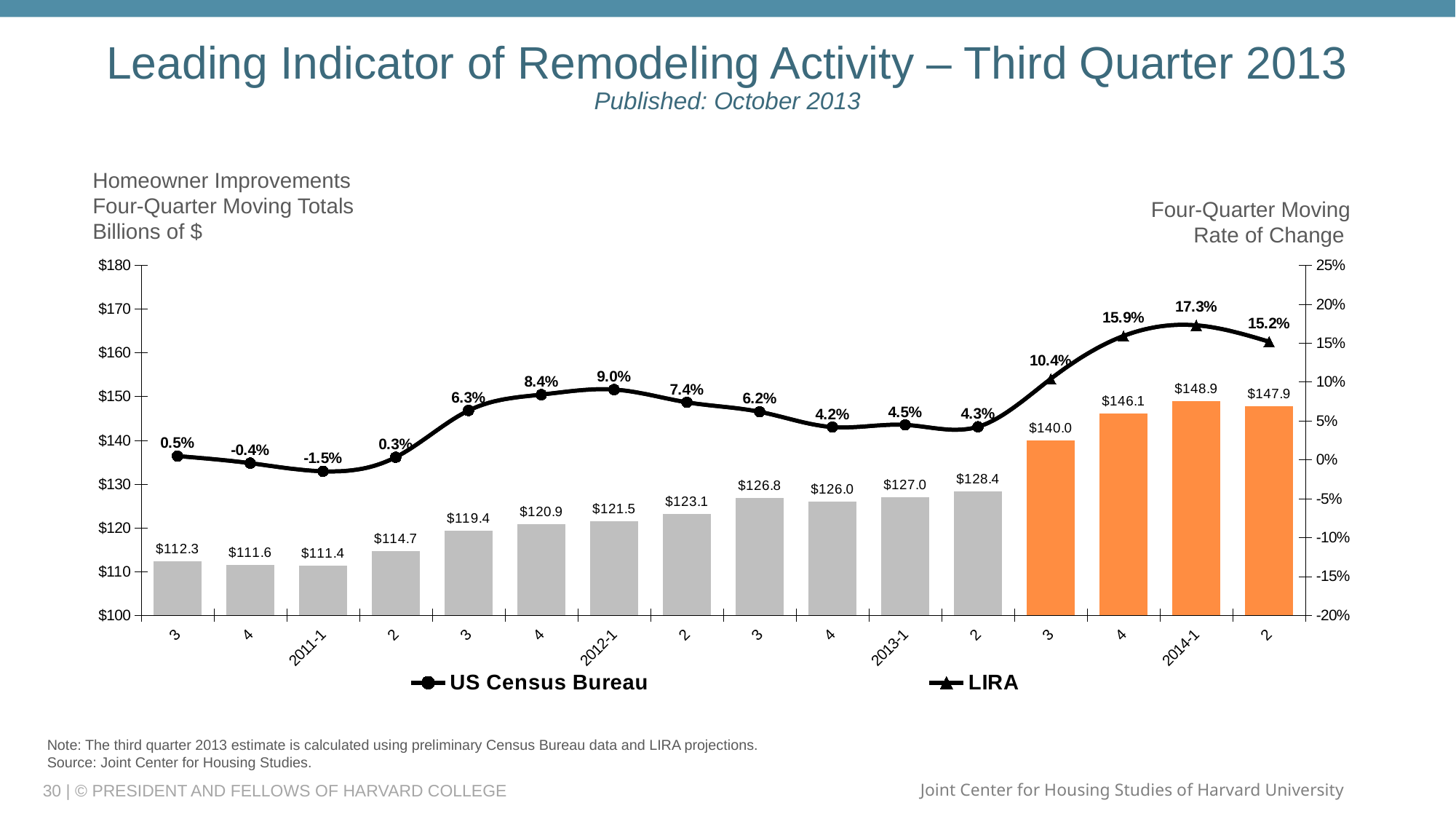
What is the four-quarter moving total (bar value) for the quarter labeled 2011-1? $111.4 What is the bar value for the quarter labeled 2013-1? $127.0 How many series does the legend list? 2 Which quarter has the lowest four-quarter moving rate of change on the line? 2011-1 Which quarter has the highest four-quarter moving total bar? 2014-1 How many quarters (bars) are plotted on the chart? 16 Which is larger, the rate of change for 2012-1 or for 2013-1? 2012-1 What are the two series named in the legend? US Census Bureau and LIRA Do the bar values generally rise or fall from the first quarter to the last quarter on the x axis? Rise What kind of chart is this? Combined bar and line chart What is the four-quarter moving rate of change shown for the quarter labeled 2014-1? 17.3% What is the difference between the bar values for 2014-1 and 2013-1? $21.9